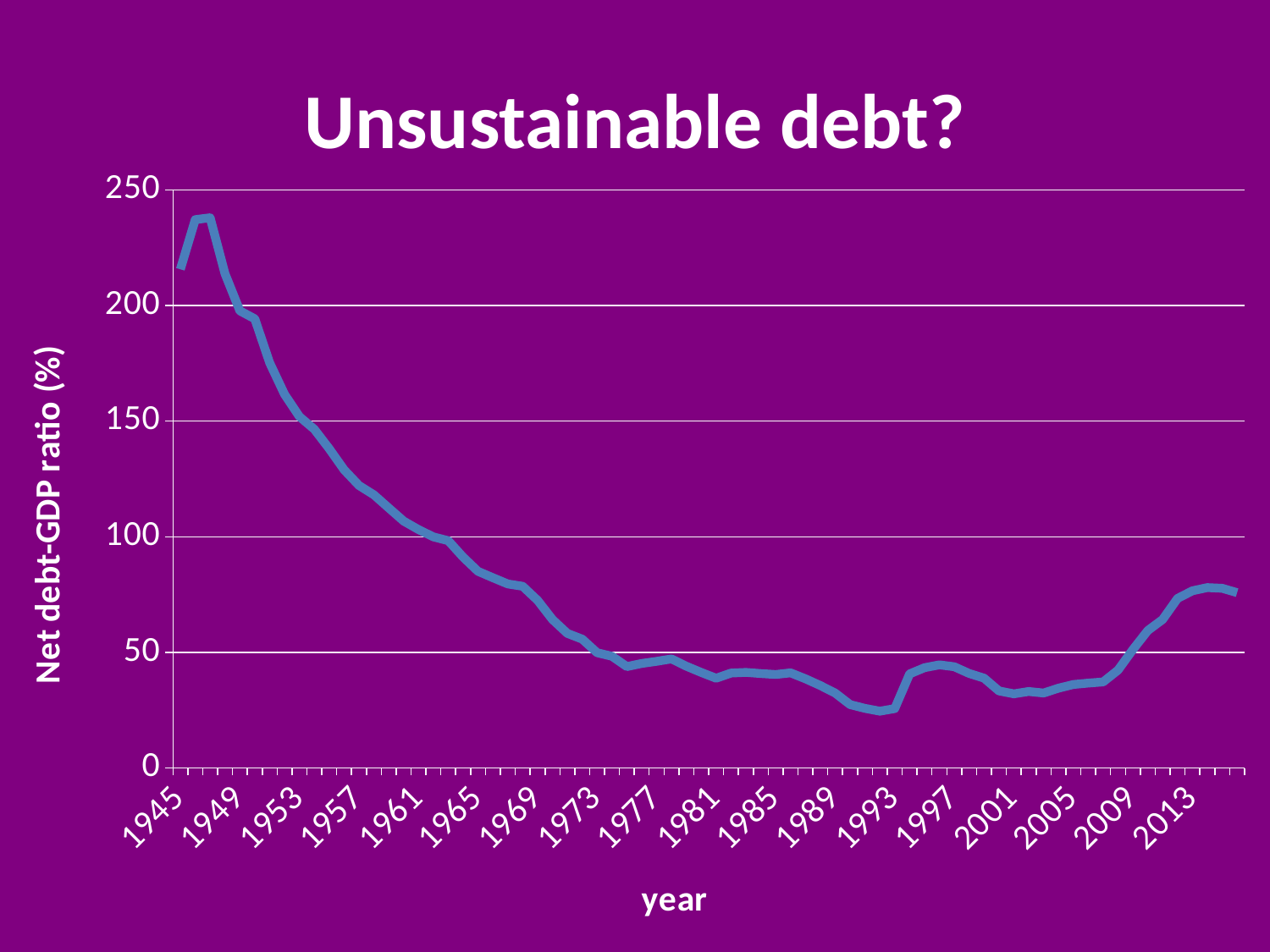
Is the value for 1993 greater or less than 50? less Which is larger, the value for 1957 or the value for 1985? 1957 Does the net debt-GDP ratio rise or fall between 1945 and 1993 overall? fall Is the value for 1965 greater or less than 100? less What kind of chart is shown on the slide? line chart What is the label on the vertical axis of the chart? Net debt-GDP ratio (%) Is the value for 1957 greater or less than 100? greater Which is larger, the value for 1945 or the value for 2013? 1945 What is the title of the chart? Unsustainable debt?